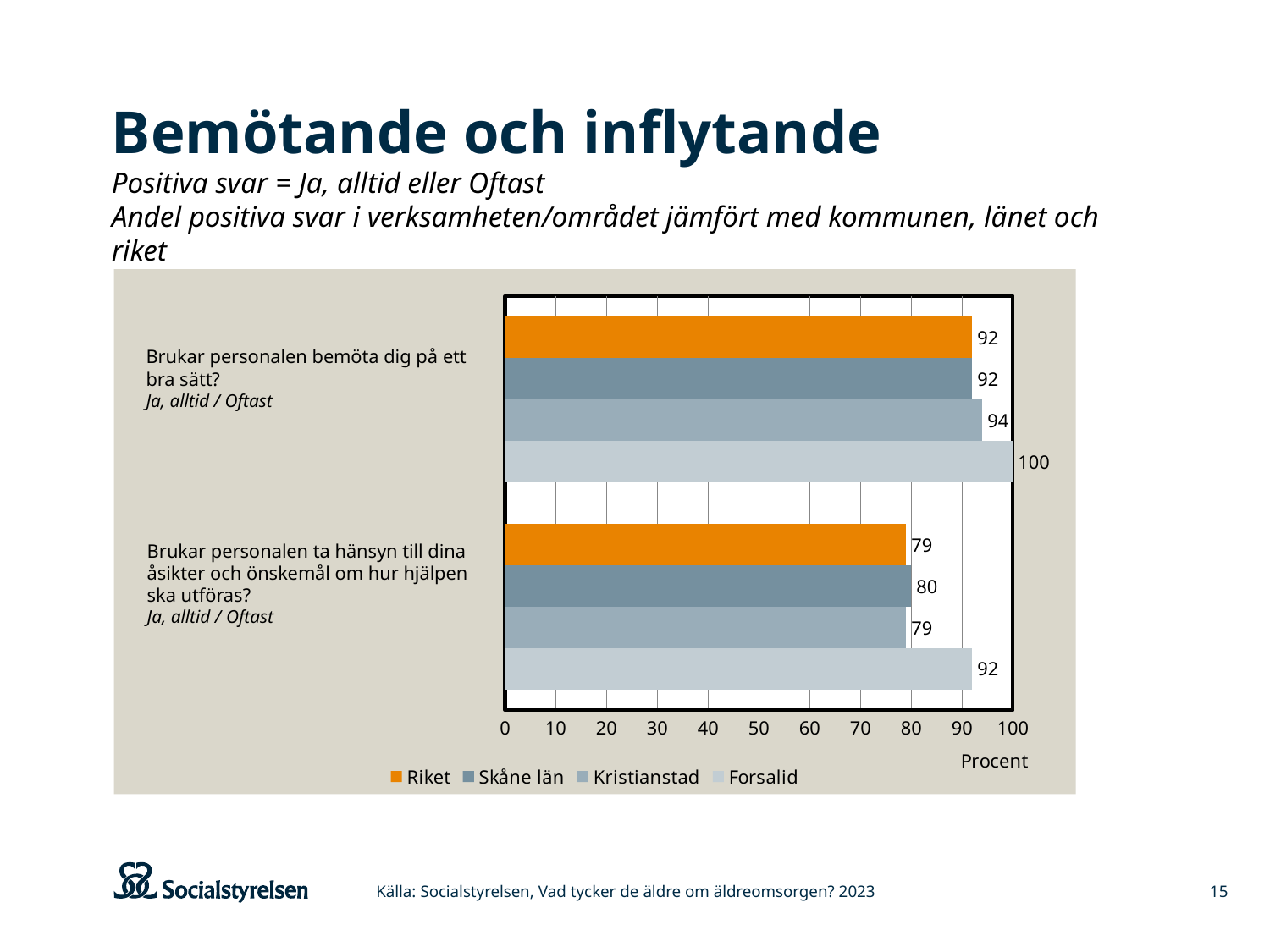
What value does Skåne län have for the question "Brukar personalen ta hänsyn till dina åsikter och önskemål om hur hjälpen ska utföras?"? 80 What is the difference between Forsalid and Riket for the question "Brukar personalen ta hänsyn till dina åsikter och önskemål om hur hjälpen ska utföras?"? 13 What is the difference between Forsalid and Kristianstad for the question "Brukar personalen bemöta dig på ett bra sätt?"? 6 How many series does the legend list? 4 What is the label of the horizontal axis? Procent Is the value for Skåne län on the question "Brukar personalen ta hänsyn till dina åsikter och önskemål om hur hjälpen ska utföras?" greater or less than 90? less What value does Forsalid have for the question "Brukar personalen bemöta dig på ett bra sätt?"? 100 What kind of chart is shown on the slide? Bar chart Which is larger for the question "Brukar personalen bemöta dig på ett bra sätt?": Kristianstad or Riket? Kristianstad What value does Kristianstad have for the question "Brukar personalen bemöta dig på ett bra sätt?"? 94 Which series has the highest value for the question "Brukar personalen ta hänsyn till dina åsikter och önskemål om hur hjälpen ska utföras?"? Forsalid What value does Riket have for the question "Brukar personalen ta hänsyn till dina åsikter och önskemål om hur hjälpen ska utföras?"? 79